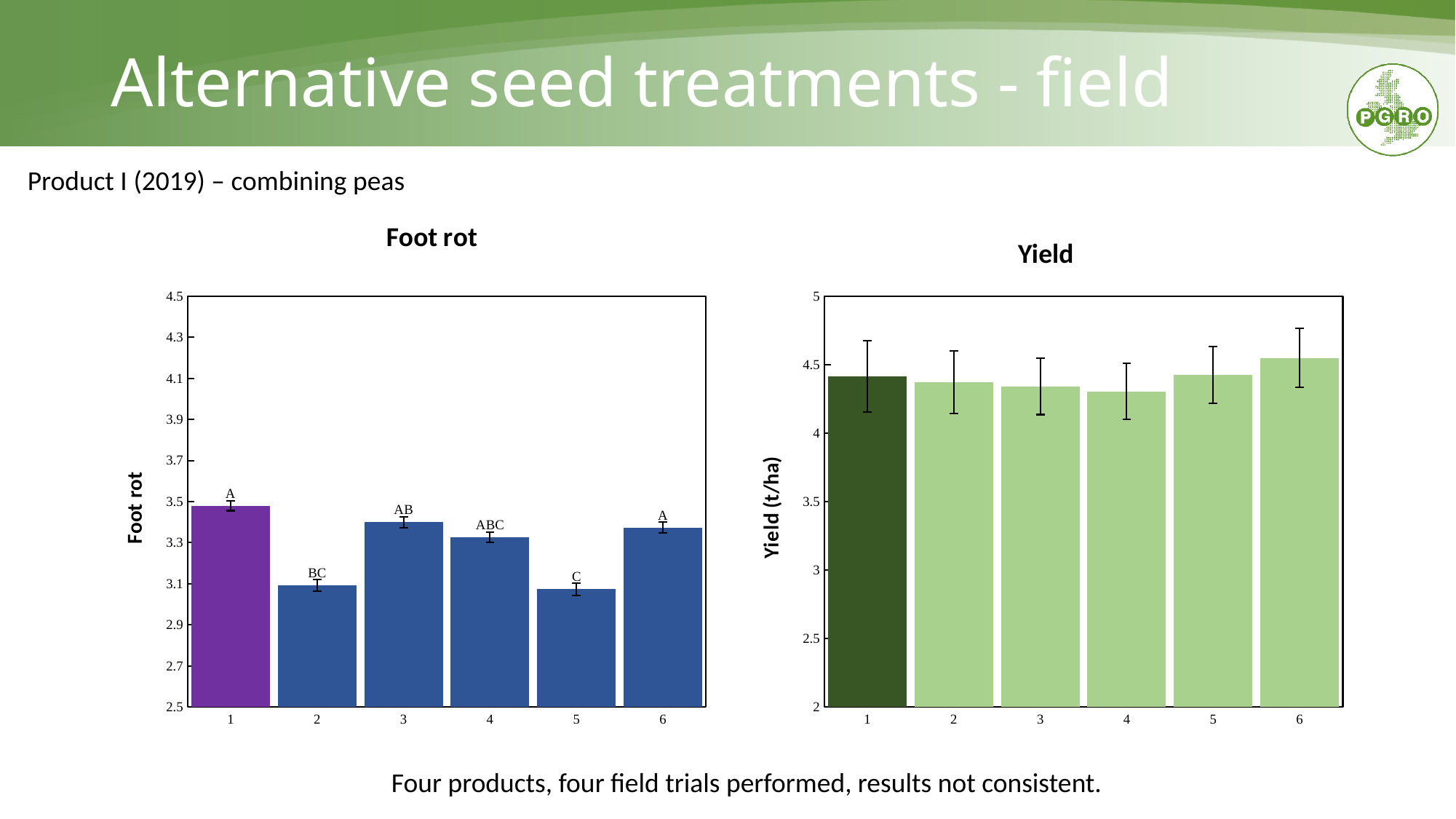
What is the y-axis label of the Yield chart? Yield (t/ha) In the Foot rot chart, which is larger, the value for category 1 or category 5? category 1 In the Foot rot chart, what letter label is printed above the bar for category 4? ABC In the Foot rot chart, is the value for category 2 greater or less than 3.3? less In the Yield chart, which is larger, the value for category 6 or category 4? category 6 In the Foot rot chart, which category has the highest bar? 1 In the Yield chart, which category has the highest bar? 6 In the Foot rot chart, is the value for category 1 greater or less than 3.3? greater In the Yield chart, is the value for category 1 greater or less than 4? greater What kind of chart is the Foot rot chart? bar chart How many categories are shown on the x axis of the Yield chart? 6